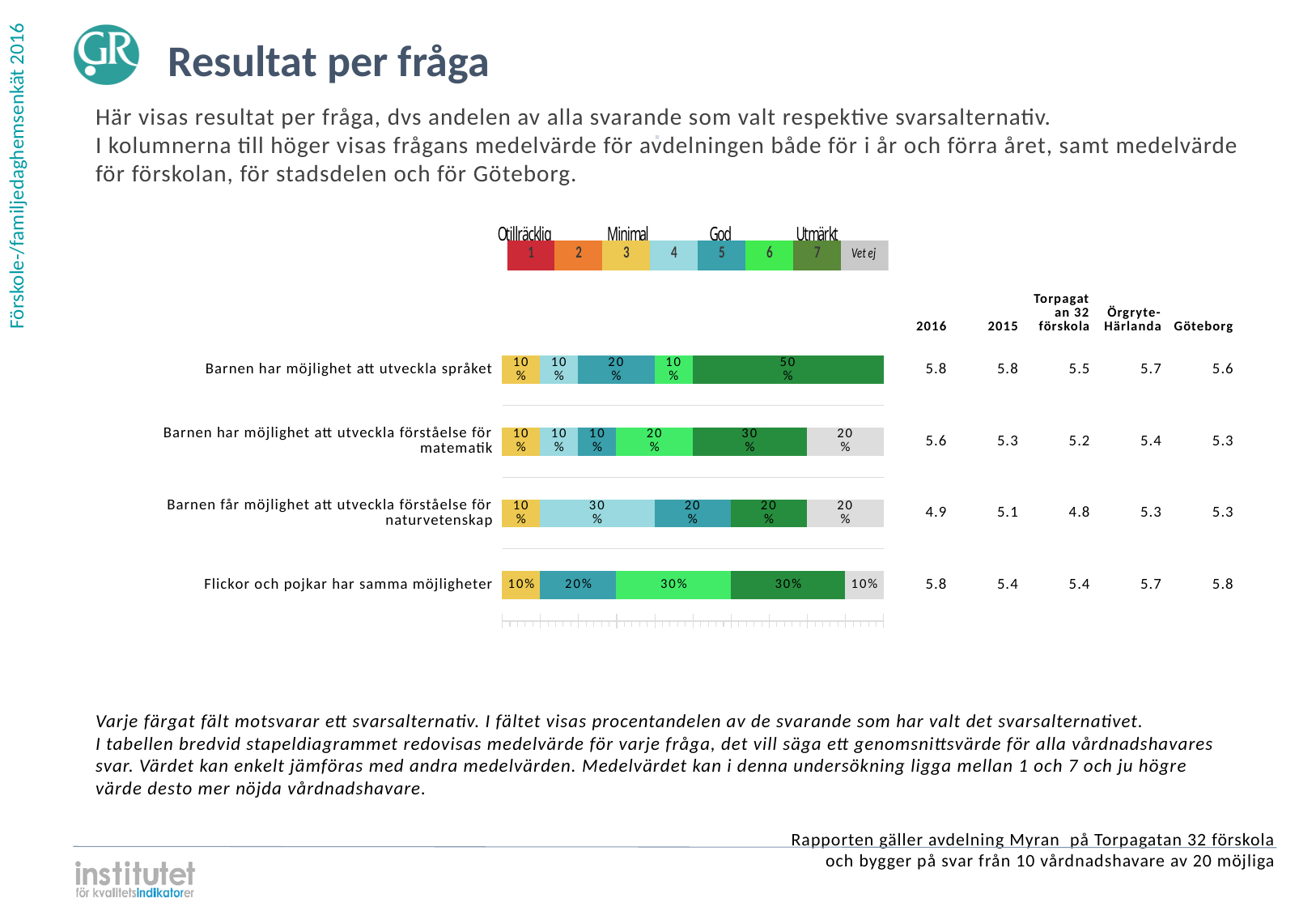
Which question has the lowest 2016 mean value? Barnen får möjlighet att utveckla förståelse för naturvetenskap What kind of chart is used to show the share of respondents choosing each answer option? Stacked bar chart What percentage of respondents answered 'Vet ej' for 'Barnen har möjlighet att utveckla förståelse för matematik'? 20% What is the difference between the 2016 and 2015 mean values for 'Flickor och pojkar har samma möjligheter'? 0.4 For 'Barnen har möjlighet att utveckla förståelse för matematik', which is larger: the 2016 mean or the Torpagatan 32 förskola mean? 2016 mean (5.6) Which answer option has the largest share for 'Barnen har möjlighet att utveckla språket'? 7 (Utmärkt), 50% What is the 2016 mean value for 'Barnen får möjlighet att utveckla förståelse för naturvetenskap'? 4.9 How many answer options does the legend above the chart list? 8 What percentage of respondents chose the light blue option 4 for 'Barnen får möjlighet att utveckla förståelse för naturvetenskap'? 30% What is the Göteborg mean value for 'Flickor och pojkar har samma möjligheter'? 5.8 What percentage of respondents chose the dark green option 7 for 'Barnen har möjlighet att utveckla språket'? 50% How many questions (bars) are shown in the chart? 4